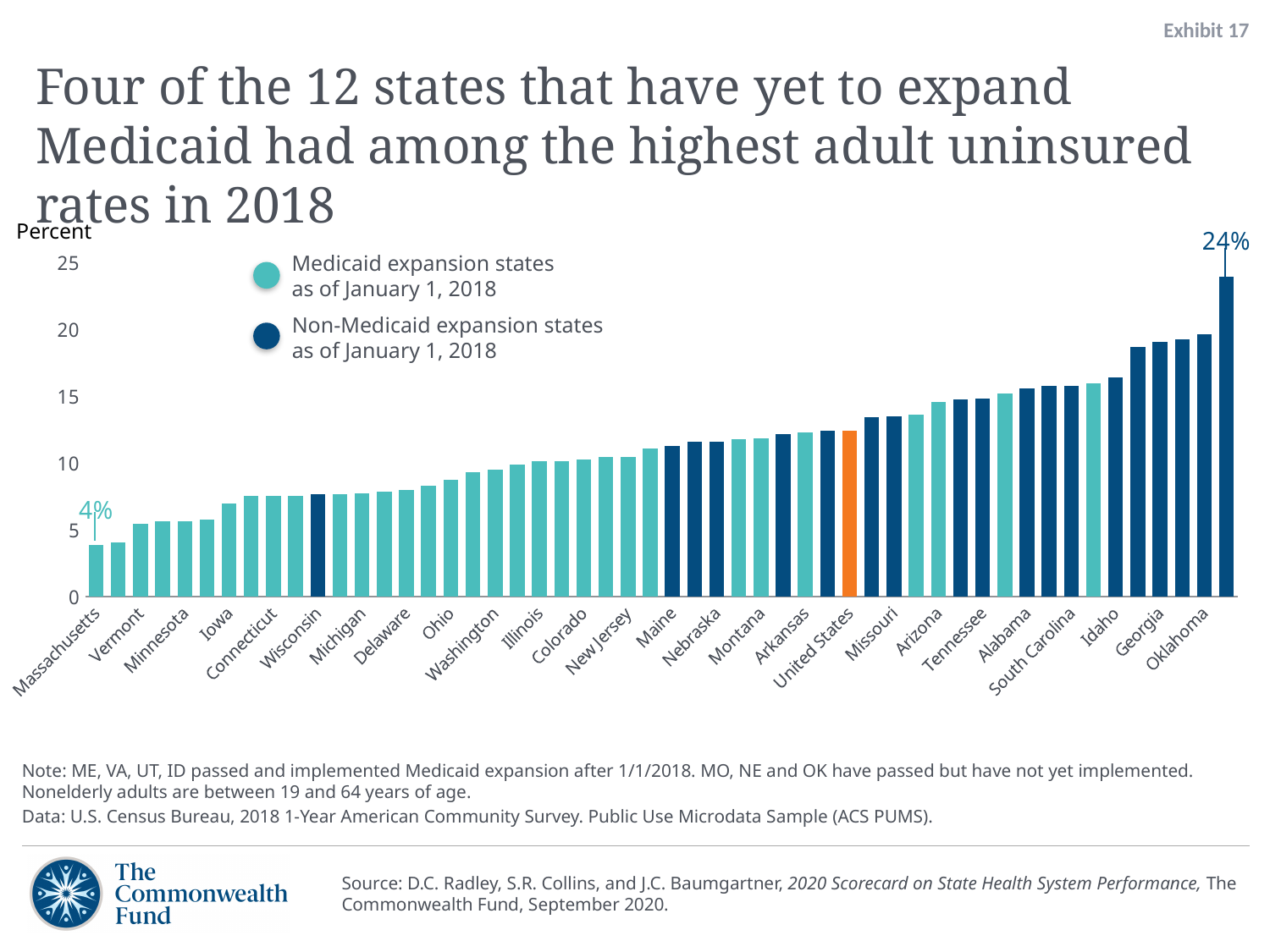
Is the value for Georgia greater or less than 20? less Is the value for Idaho greater or less than 15? greater Do the uninsured rates rise or fall moving from left to right along the x axis? Rise Which state has the lowest adult uninsured rate on the chart? Massachusetts Is the value for United States greater or less than 10? greater What kind of chart is shown on the slide? Bar chart How many series does the legend list? 2 What is the adult uninsured rate shown for Massachusetts? 4%